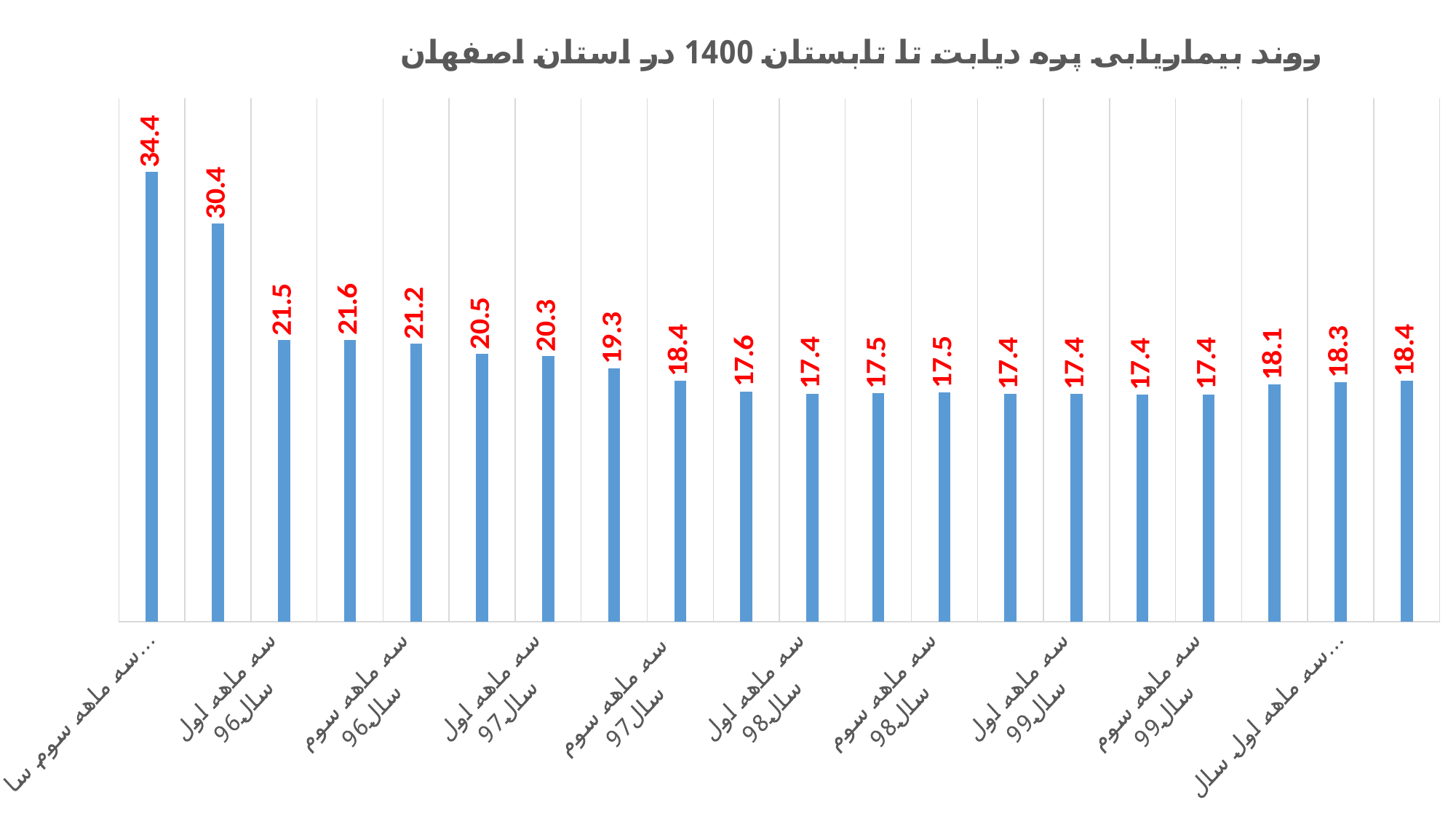
What is the highest value shown in the chart? 34.4 How many bars are plotted in the chart? 20 What is the lowest value shown in the chart? 17.4 What is the difference between the first bar (34.4) and the second bar (30.4)? 4.0 What is the value for سه ماهه اول سال96? 21.5 Do the values generally rise or fall from left to right across the chart? fall What is the value for سه ماهه سوم سال97? 18.4 What is the value of the first (leftmost) bar in the chart? 34.4 What is the value of the second bar from the left? 30.4 What is the value of the last (rightmost) bar in the chart? 18.4 What kind of chart is shown on the slide? bar chart Which is larger, the value for سه ماهه اول سال96 or the value for سه ماهه اول سال98? سه ماهه اول سال96